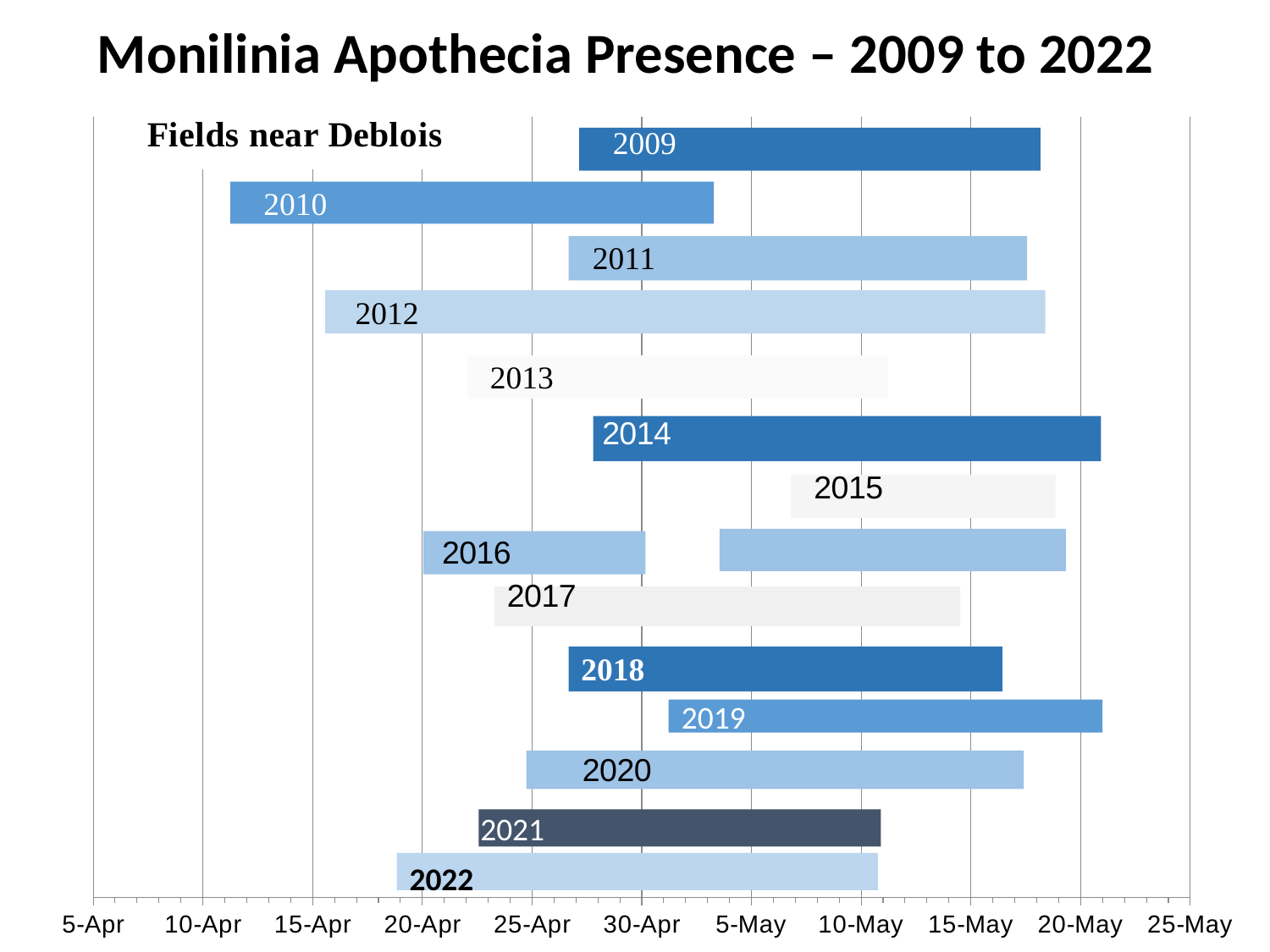
Does the bar for 2022 start before or after 20-Apr? before Which year's bar starts latest on the date axis? 2015 Which year's bar starts earlier, 2010 or 2012? 2010 What kind of chart is shown on the slide? bar chart What location label appears inside the chart area? Fields near Deblois How many years are plotted as bars on the chart? 14 Does the bar for 2015 start before or after 5-May? after What is the title of the chart? Monilinia Apothecia Presence – 2009 to 2022 Does the bar for 2018 end before or after 20-May? before Which year's bar starts earliest on the date axis? 2010